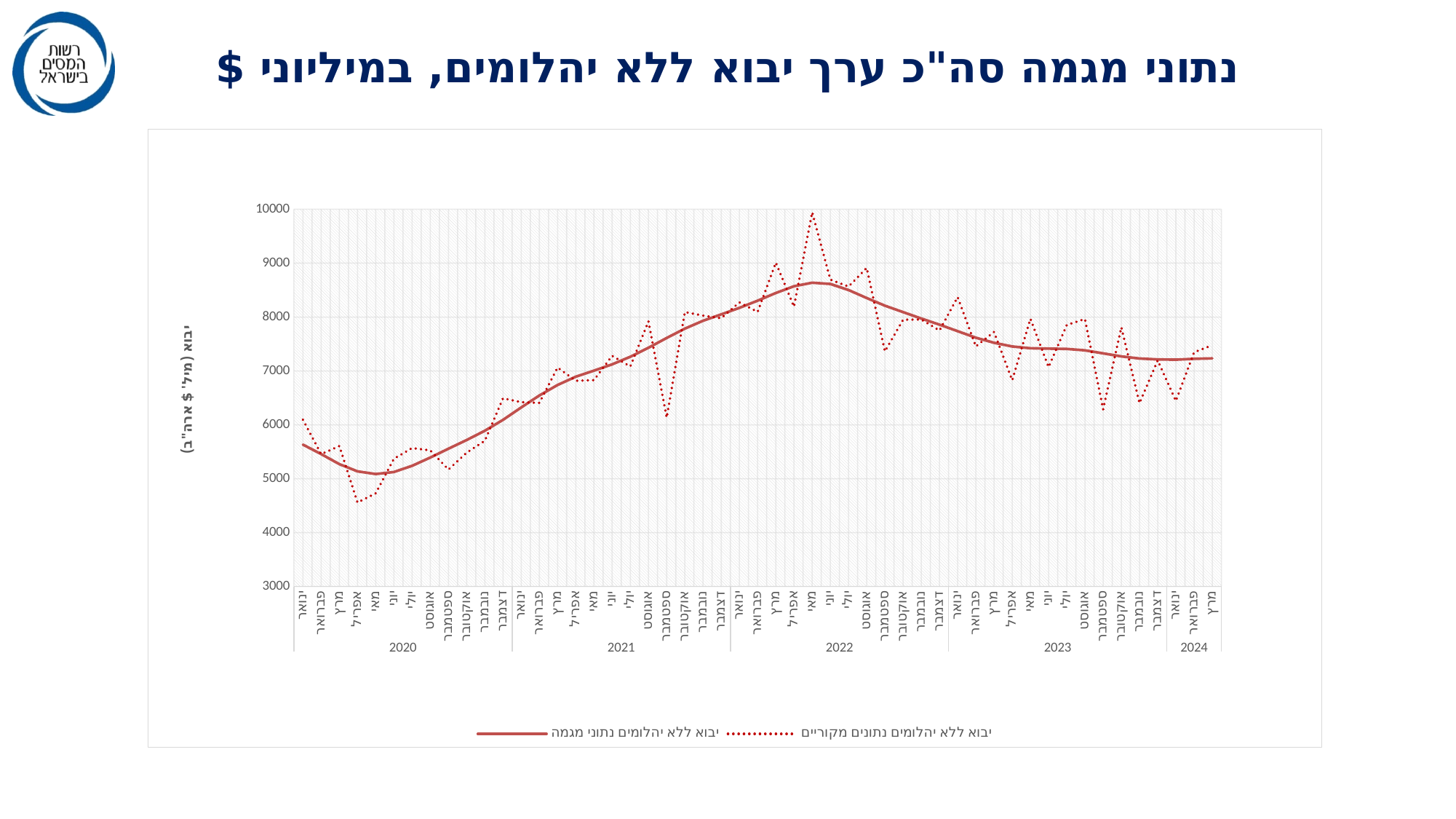
Does the solid trend line rise or fall between January 2020 and mid-2022? rise Is the dotted original-data value for April 2020 greater or less than 5000? less Is the solid trend line value at the start of 2024 greater or less than 7000? greater Does the solid trend line rise or fall from mid-2022 to the end of 2023? fall Is the solid trend line at its peak in 2022 greater or less than 8000? greater Which series is drawn as a dotted line? יבוא ללא יהלומים נתונים מקוריים In which year does the dotted original-data series reach its highest point? 2022 How many series does the legend list? 2 What is the lowest value shown on the vertical axis? 3000 What kind of chart is shown on the slide? line chart